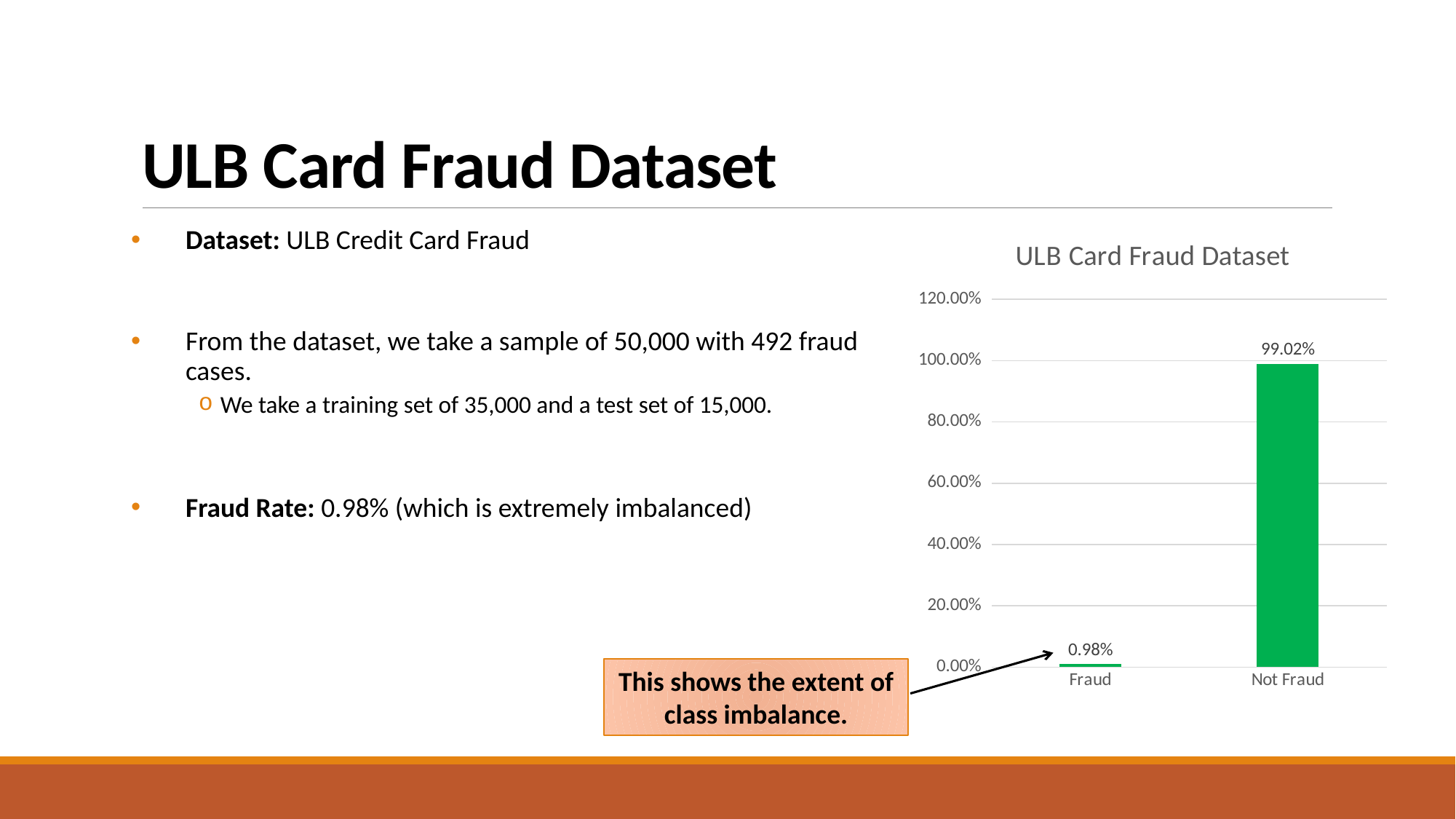
Which category has the lowest value in the chart? Fraud Which is larger, the value for Fraud or the value for Not Fraud? Not Fraud How many categories are shown in the chart? 2 Which category has the highest value in the chart? Not Fraud What is the value for Not Fraud in the chart? 99.02% What is the highest value shown on the chart's vertical axis? 120.00% What kind of chart is shown on the slide? Bar chart What is the difference between the Not Fraud and Fraud values? 98.04% Is the value for Fraud greater or less than 20.00%? less What is the title of the chart? ULB Card Fraud Dataset Is the value for Not Fraud greater or less than 80.00%? greater What is the value for Fraud in the chart? 0.98%